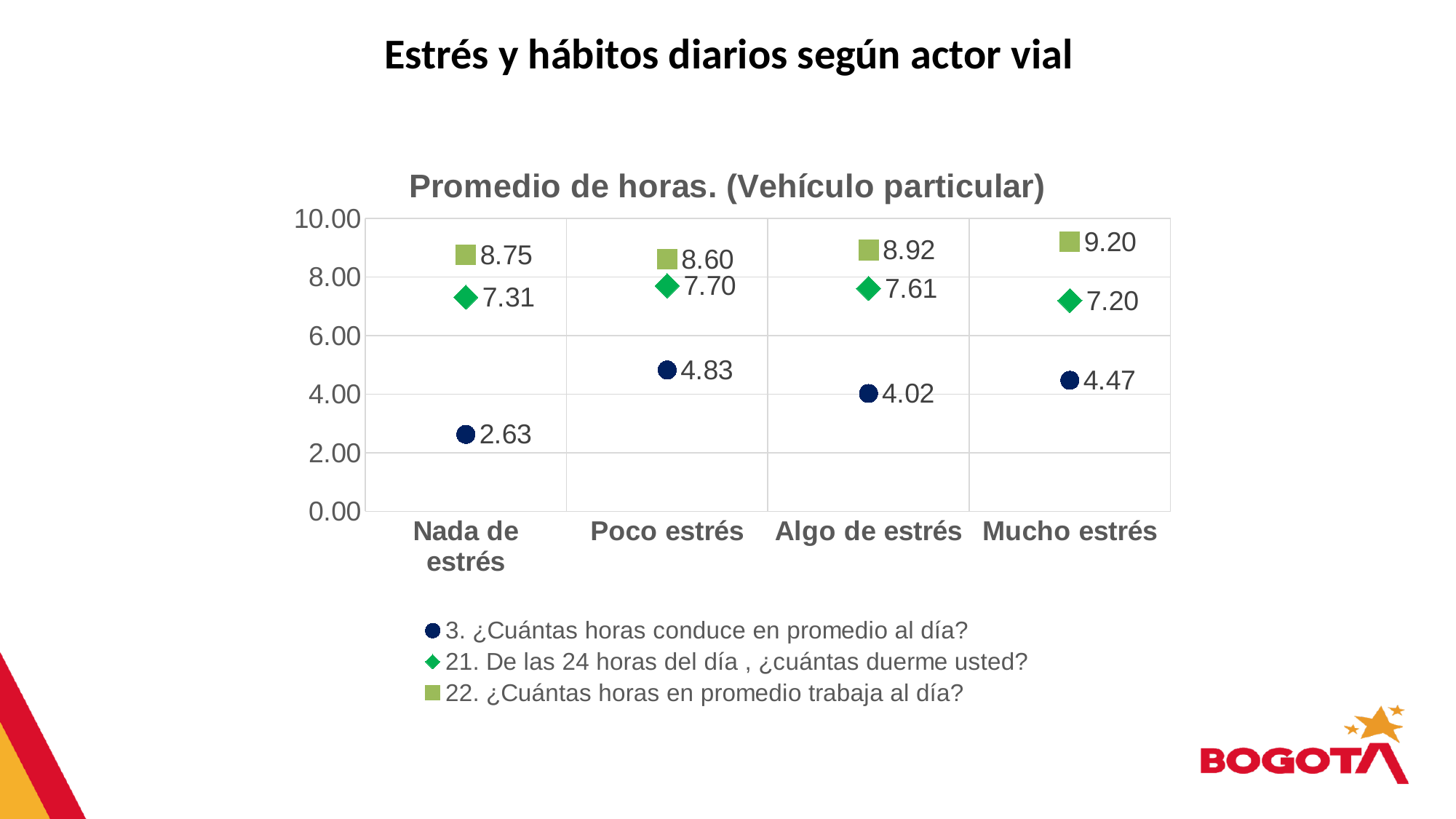
What is the title of the chart? Promedio de horas. (Vehículo particular) How many series does the legend list? 3 How many categories are shown on the x axis? 4 What is the value for 'Mucho estrés' in the series '22. ¿Cuántas horas en promedio trabaja al día?'? 9.20 What is the difference between the 'Poco estrés' and 'Nada de estrés' values in the series '3. ¿Cuántas horas conduce en promedio al día?'? 2.20 In the series '21. De las 24 horas del día, ¿cuántas duerme usted?', which is larger: 'Poco estrés' or 'Mucho estrés'? Poco estrés Which category has the lowest value in the series '21. De las 24 horas del día, ¿cuántas duerme usted?'? Mucho estrés Which category has the highest value in the series '22. ¿Cuántas horas en promedio trabaja al día?'? Mucho estrés Which category has the lowest value in the series '3. ¿Cuántas horas conduce en promedio al día?'? Nada de estrés Is the value for 'Algo de estrés' in the series '3. ¿Cuántas horas conduce en promedio al día?' greater or less than 6.00? less What is the value for 'Nada de estrés' in the series '3. ¿Cuántas horas conduce en promedio al día?'? 2.63 What is the value for 'Poco estrés' in the series '21. De las 24 horas del día, ¿cuántas duerme usted?'? 7.70